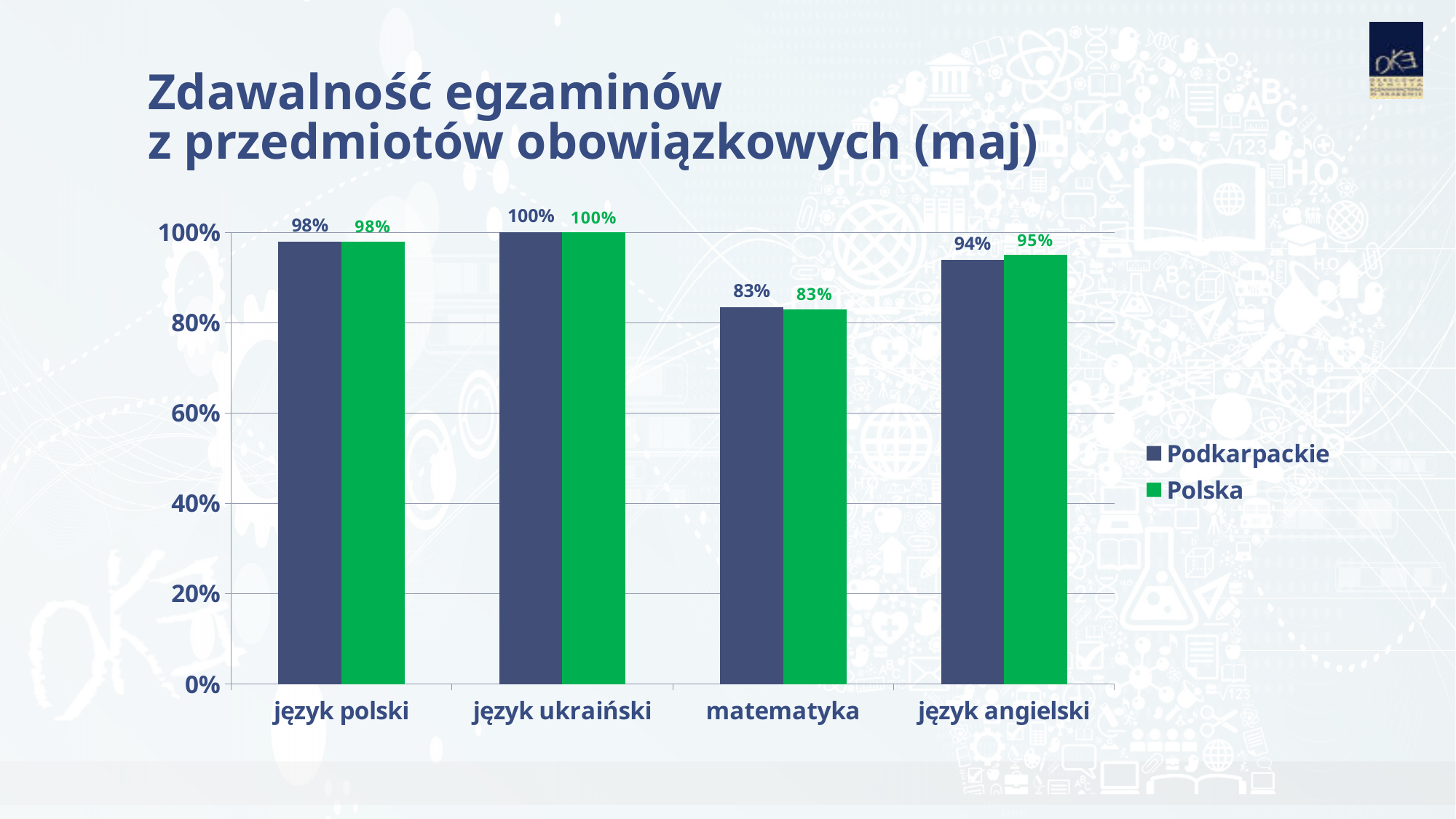
What is the difference between the Polska and Podkarpackie values for język angielski? 1% What is the value for Polska in język angielski? 95% What is the value for Podkarpackie in matematyka? 83% What kind of chart is shown on the slide? bar chart What is the difference between the Podkarpackie values for język ukraiński and matematyka? 17% What is the value for Podkarpackie in język polski? 98% How many subjects are shown on the x axis? 4 Which subject has the lowest value for Podkarpackie? matematyka How many series does the legend list? 2 Which colour represents Polska in the legend? green Which subject has the highest value for Polska? język ukraiński What is the value for Polska in język ukraiński? 100%